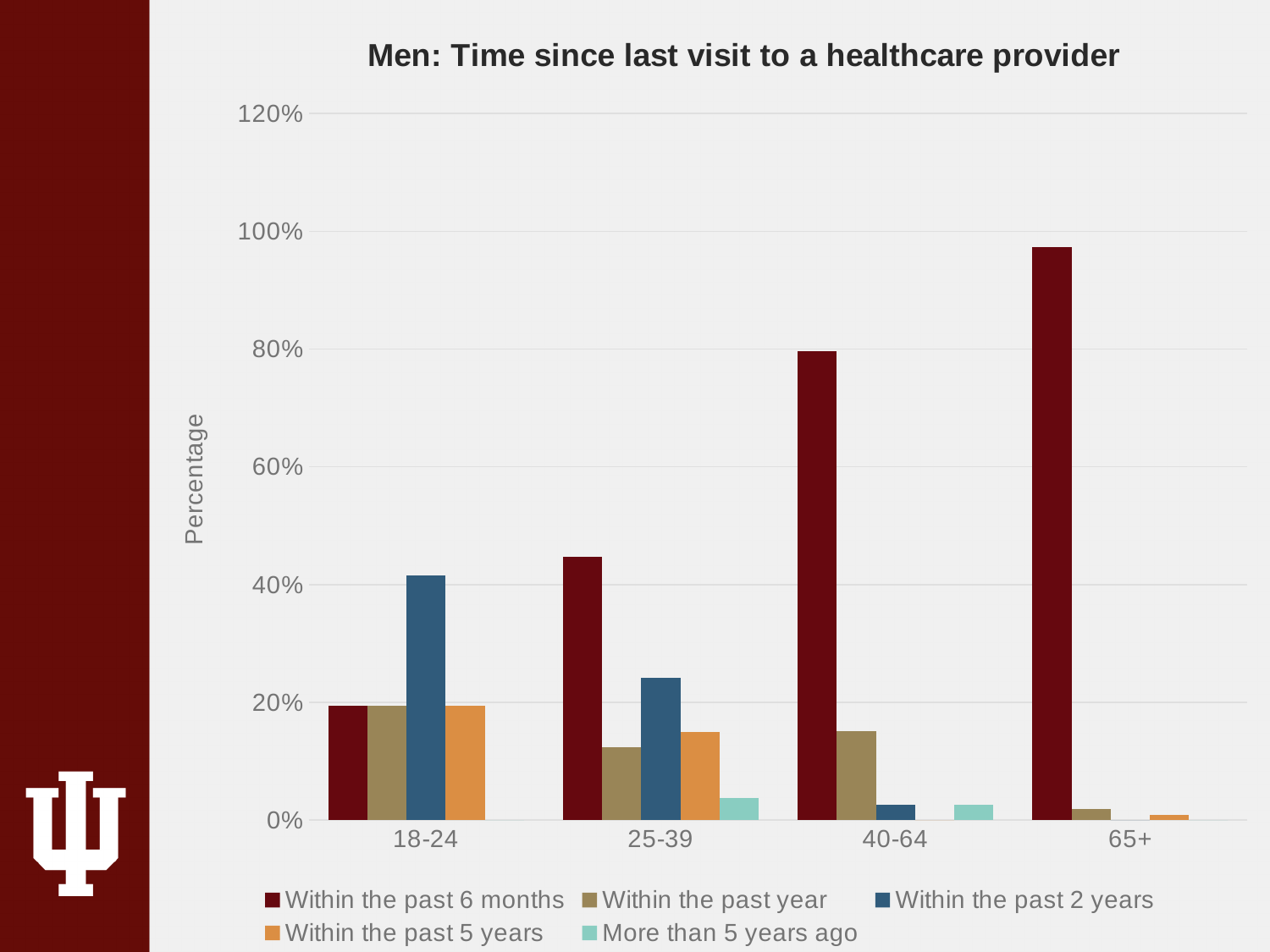
In the 25-39 group, which is larger: 'Within the past 6 months' or 'Within the past 2 years'? Within the past 6 months In the 18-24 group, which is larger: 'Within the past 6 months' or 'Within the past 2 years'? Within the past 2 years Is the value for 'Within the past 6 months' in the 65+ group greater or less than 80%? greater What kind of chart is shown on the slide? bar chart Which age group has the highest value for 'Within the past 6 months'? 65+ Is the value for 'Within the past 2 years' in the 18-24 group greater or less than 30%? greater Is the value for 'Within the past 6 months' in the 40-64 group greater or less than 60%? greater How many series does the legend list? 5 How many age groups are shown on the x axis? 4 Which age group has the lowest value for 'Within the past 6 months'? 18-24 Do the values for 'Within the past 6 months' rise or fall as age group increases along the x axis? rise What is the title of the y axis? Percentage